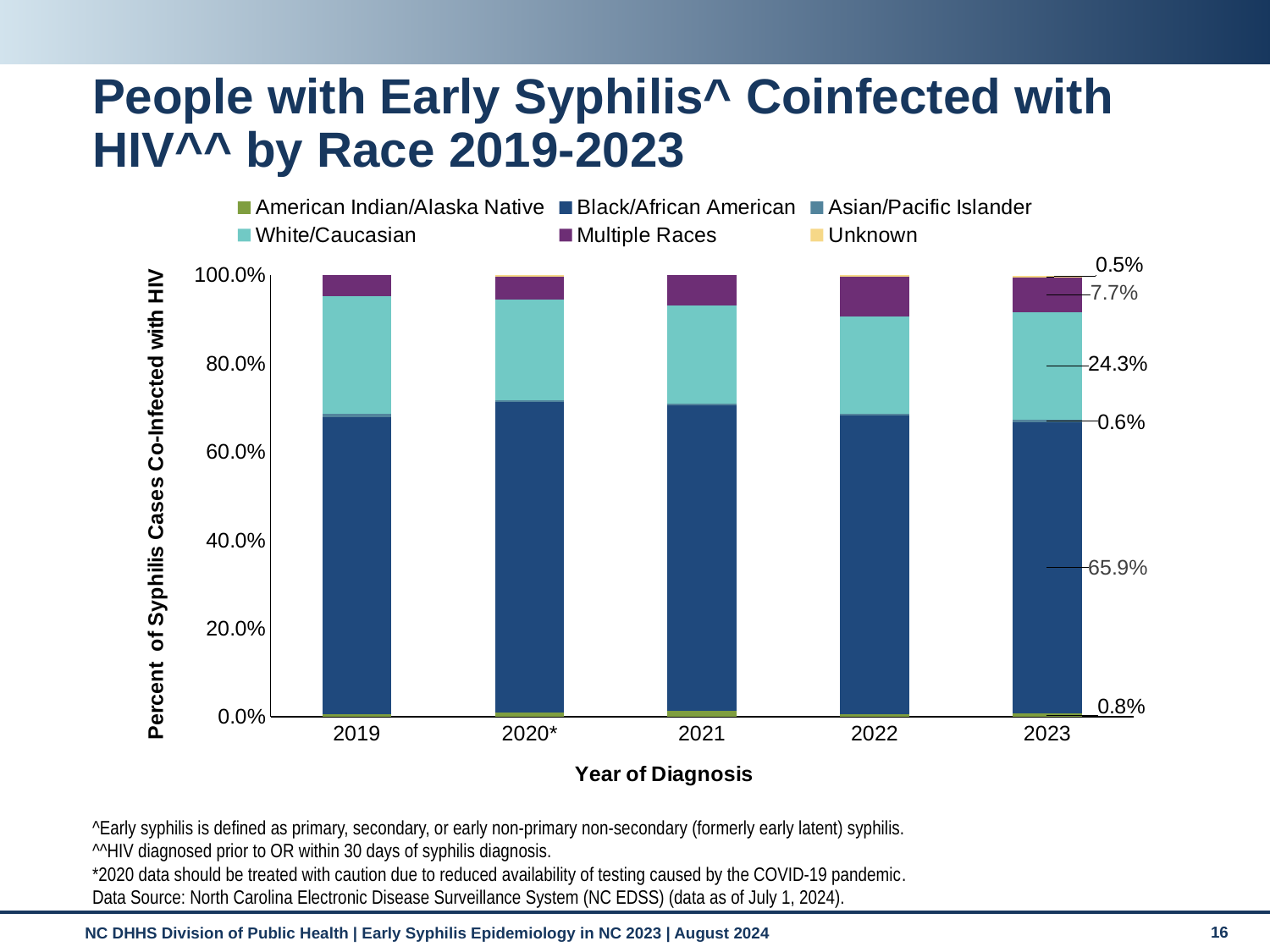
Which race group has the lowest share in 2023? Unknown What is the value for Black/African American in 2023? 65.9% What is the value for Multiple Races in 2023? 7.7% What is the value for American Indian/Alaska Native in 2023? 0.8% What is the title of the x axis? Year of Diagnosis What is the difference between the Black/African American and White/Caucasian values in 2023? 41.6% How many series does the legend list? 6 How many years of diagnosis are shown on the x axis? 5 What kind of chart is shown on the slide? bar chart Which race group has the highest share in 2023? Black/African American What is the value for White/Caucasian in 2023? 24.3% Is the value for Black/African American in 2019 greater or less than 60.0%? greater